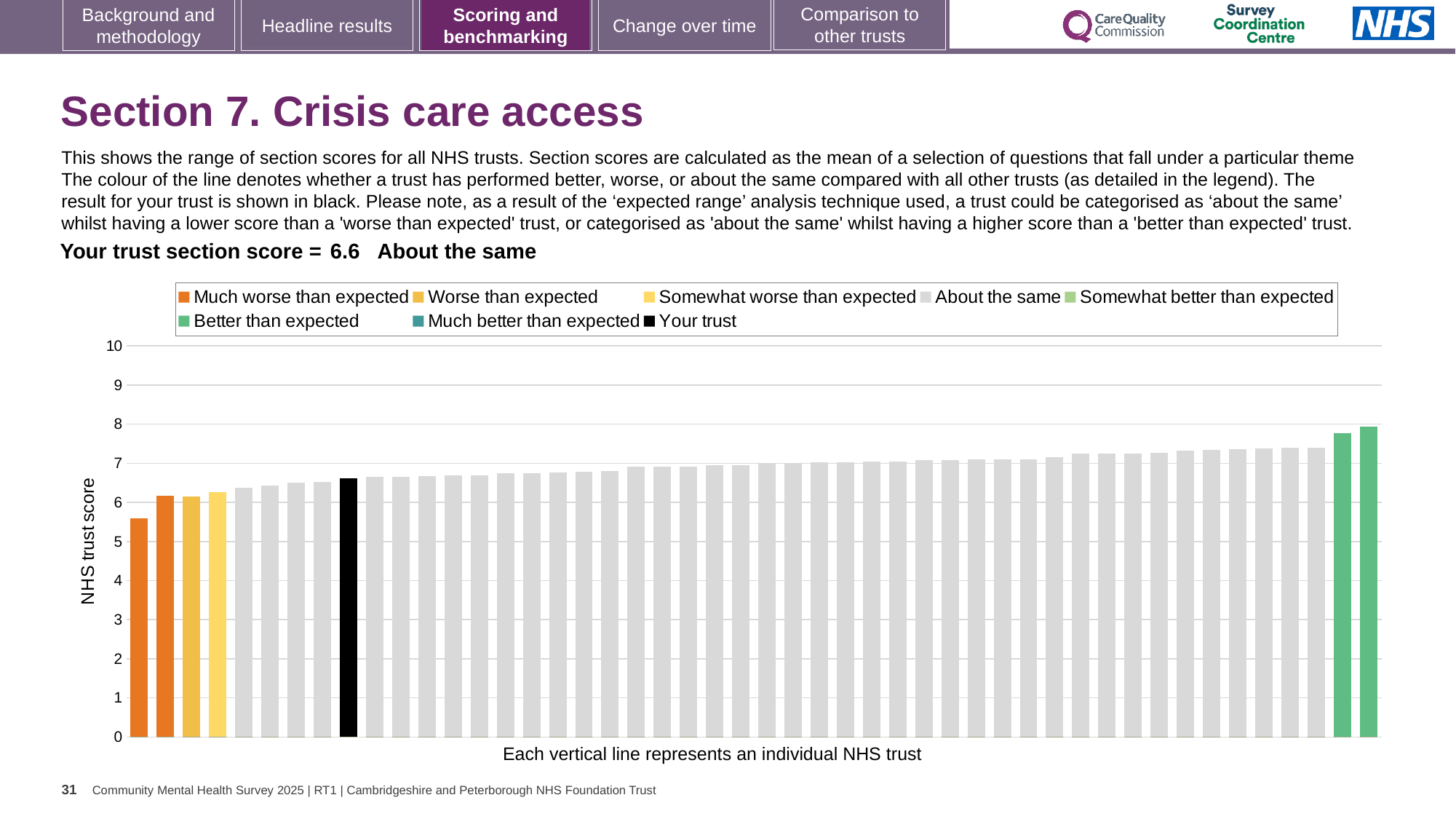
Which category is the trust's section score placed in, according to the text above the chart? About the same How many entries does the chart legend list? 8 What is the trust's section score for Section 7, Crisis care access, as printed on the slide? 6.6 What kind of chart is shown on the slide? bar chart Do the bar heights rise or fall from left to right across the chart? rise How many bars are coloured green ('Better than expected')? 2 What is the label on the vertical axis of the chart? NHS trust score How many bars are coloured orange ('Much worse than expected')? 2 Is the value of the highest (rightmost) bar greater or less than 7? greater Is the value of the lowest (leftmost) bar greater or less than 6? less Is the value of the black 'Your trust' bar greater or less than 6? greater